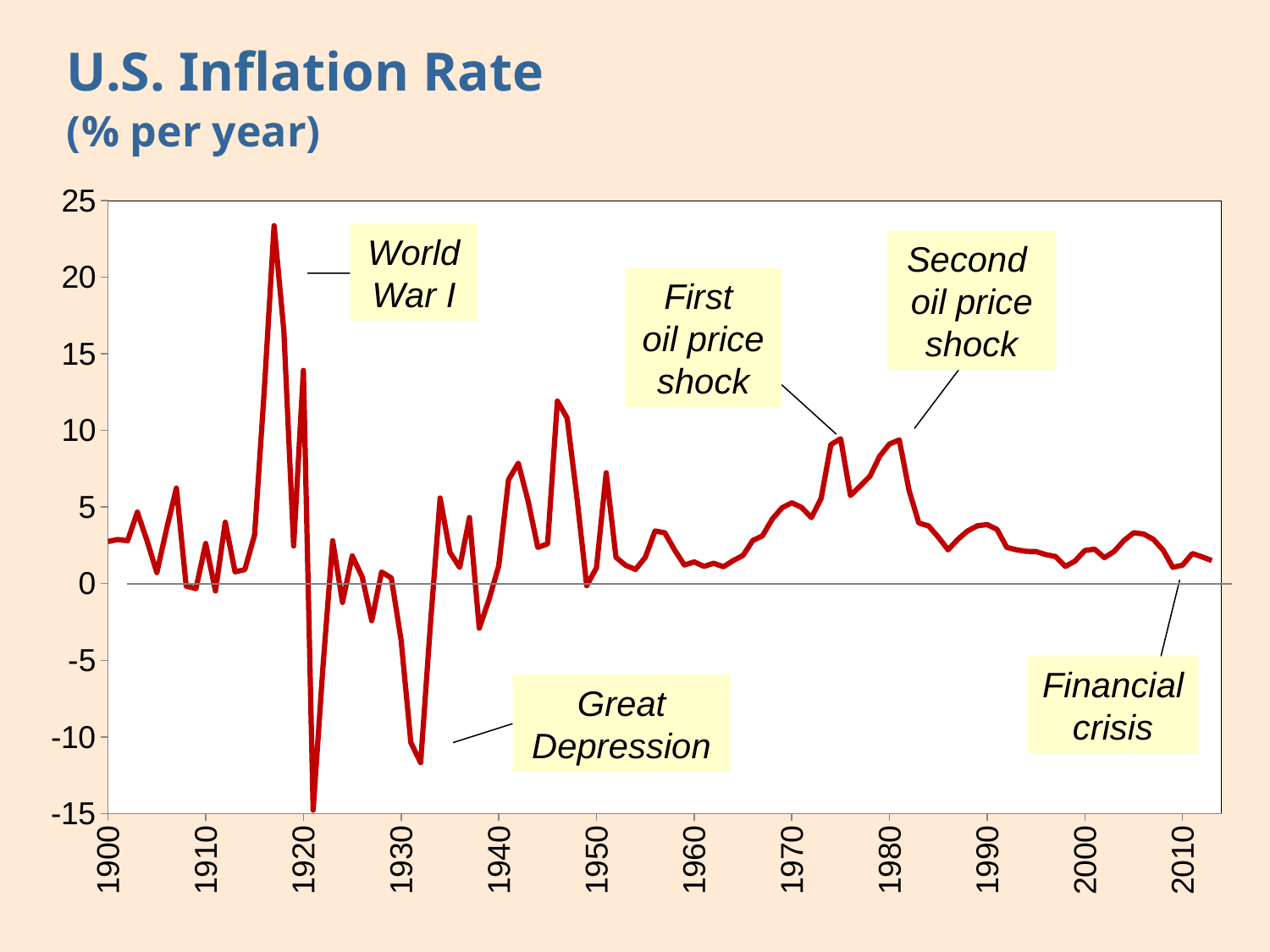
Does the inflation rate generally rise or fall between 1980 and 1990? fall What is the title of the chart? U.S. Inflation Rate (% per year) Is the inflation rate around 1921 greater or less than -10? less What kind of chart is shown on the slide? line chart Is the inflation rate at the Financial crisis point greater or less than 5? less Is the inflation rate at the World War I peak greater or less than 20? greater Which is higher, the inflation rate at the World War I peak or at the First oil price shock peak? World War I peak How many annotated events are labelled on the chart? 5 Which annotated event corresponds to the highest inflation rate on the chart? World War I